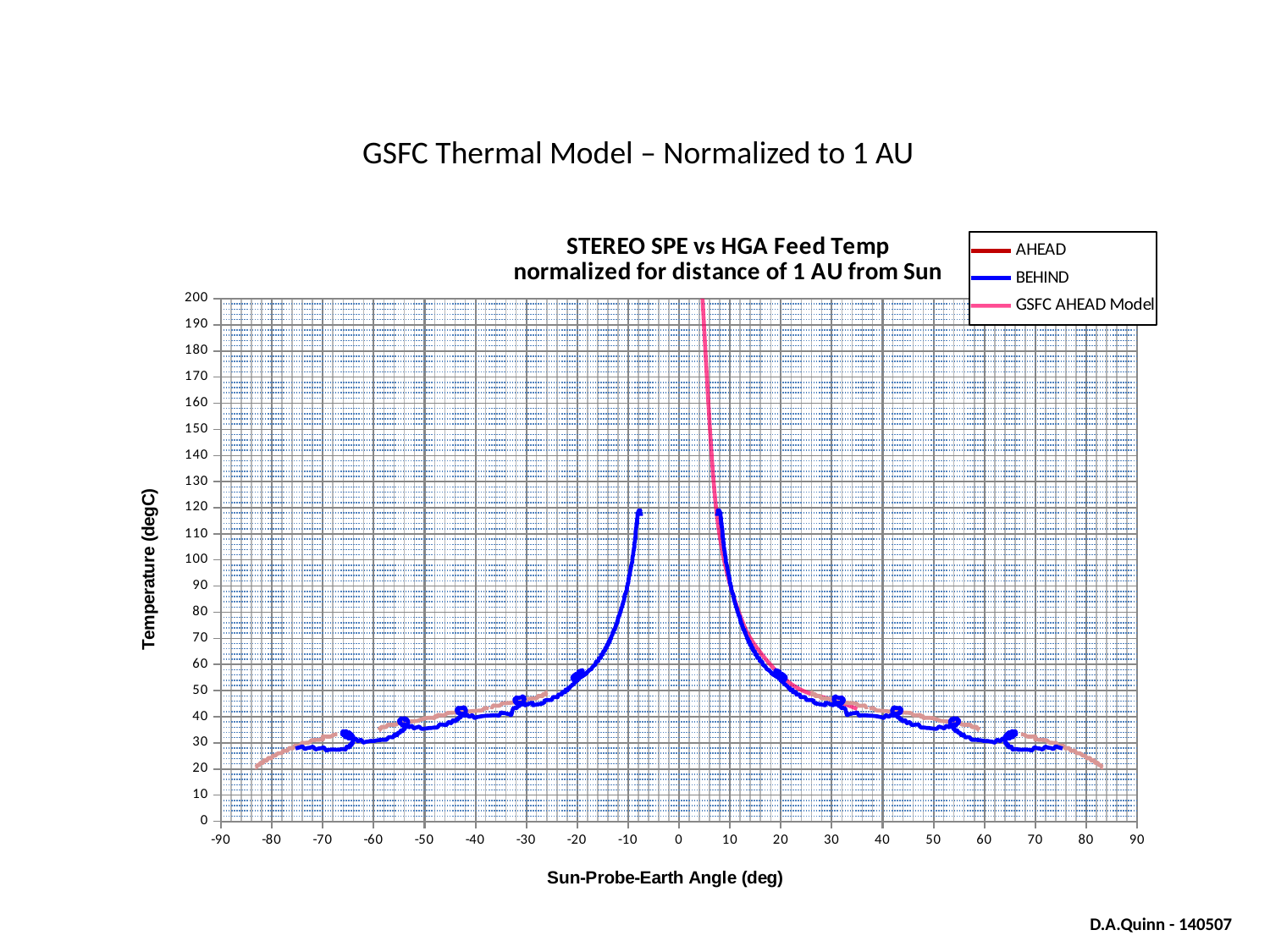
What is the maximum value shown on the vertical axis of the chart? 200 How many series does the chart legend list? 3 What kind of chart is shown on the slide? line chart Is the BEHIND value at a Sun-Probe-Earth angle of 20 degrees greater or less than 40? greater Is the BEHIND value at a Sun-Probe-Earth angle of 70 degrees greater or less than 40? less Do the BEHIND values rise or fall as the Sun-Probe-Earth angle increases from 10 to 80 degrees? fall Do the BEHIND values rise or fall as the Sun-Probe-Earth angle increases from -80 to -10 degrees? rise What is the label of the vertical axis? Temperature (degC) Is the GSFC AHEAD Model value at a Sun-Probe-Earth angle of -80 degrees greater or less than 30? less Which is larger, the BEHIND value at -60 degrees or the BEHIND value at -20 degrees? -20 degrees What is the title of the chart? STEREO SPE vs HGA Feed Temp normalized for distance of 1 AU from Sun